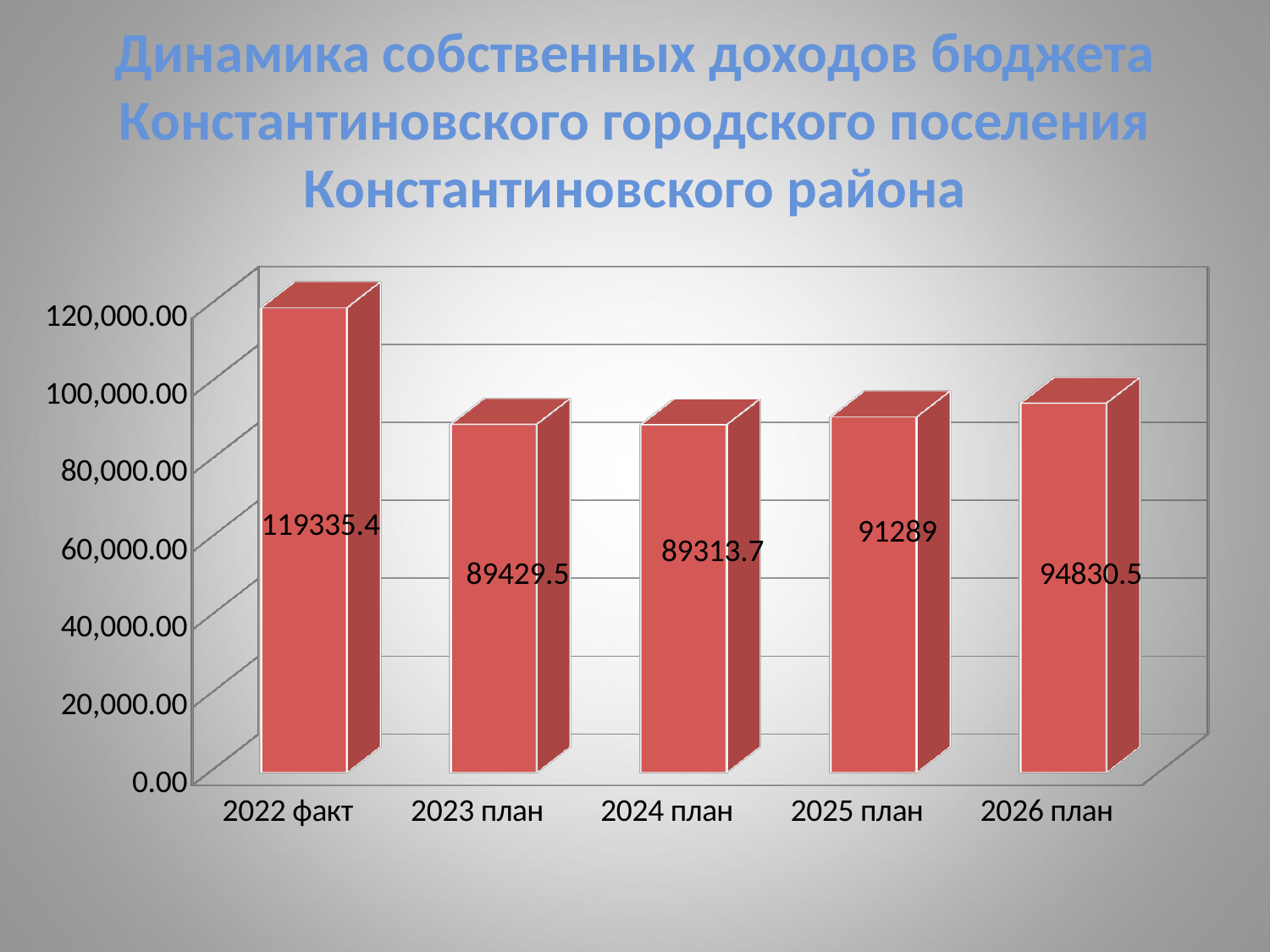
Which category has the highest value? 2022 факт What is the value for 2025 план? 91289 How many categories are shown on the x axis? 5 Is the value for 2026 план greater or less than 100,000.00? less What kind of chart is shown on the slide? bar chart From 2023 план to 2026 план, do the values rise or fall? rise Which category has the lowest value? 2024 план What is the value for 2026 план? 94830.5 What is the difference between the values for 2022 факт and 2023 план? 29905.9 What is the value for 2022 факт? 119335.4 What is the difference between the values for 2026 план and 2025 план? 3541.5 Which is larger, the value for 2022 факт or the value for 2026 план? 2022 факт